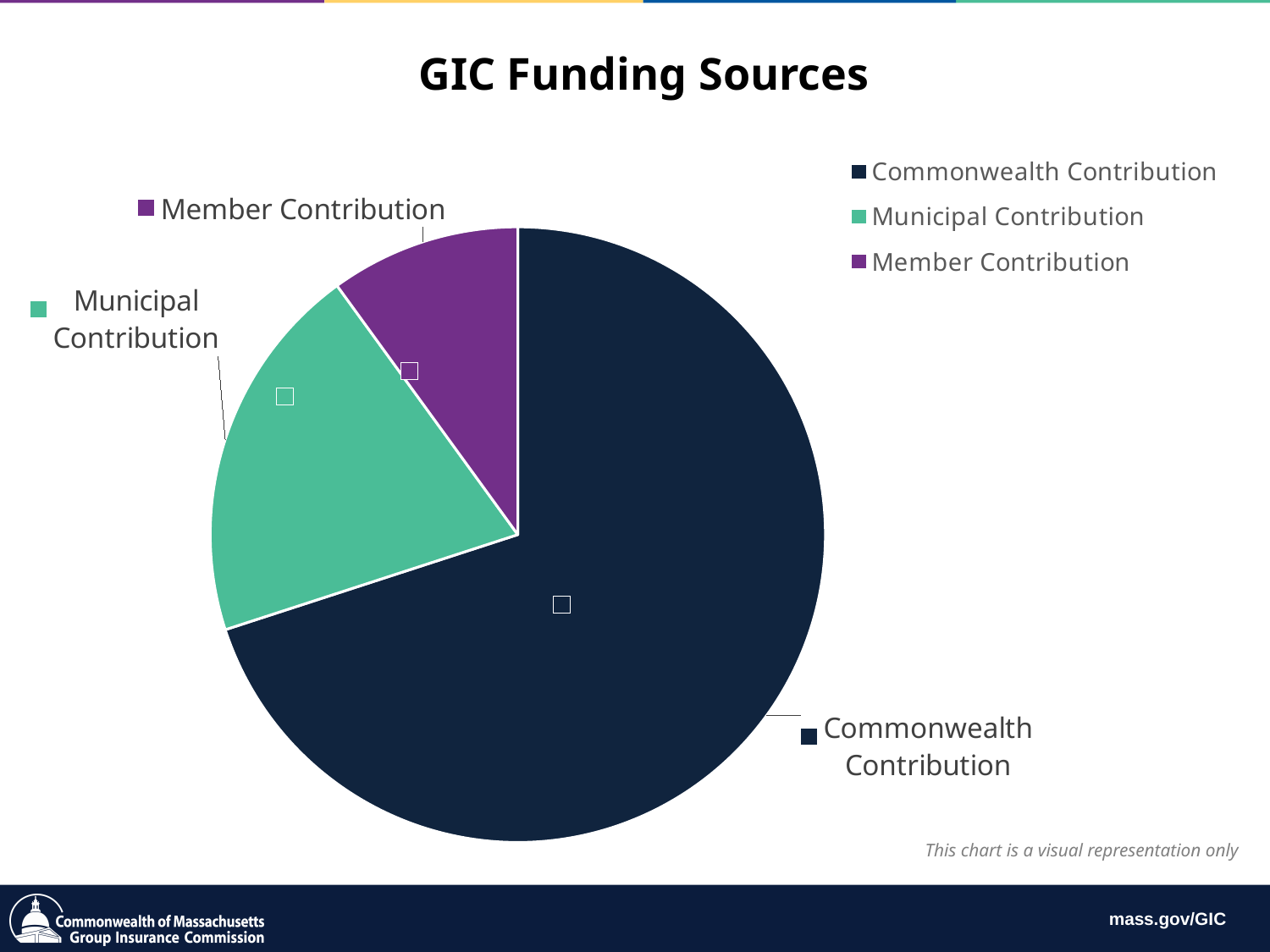
What is the title of the chart? GIC Funding Sources Which is larger, the Municipal Contribution slice or the Member Contribution slice? Municipal Contribution Which funding source has the smallest slice of the pie? Member Contribution What kind of chart is shown on the slide? pie chart How many slices does the pie chart have? 3 What colour is the Municipal Contribution slice? green How many entries does the legend list? 3 Which is larger, the Commonwealth Contribution slice or the Municipal Contribution slice? Commonwealth Contribution Which funding source has the largest slice of the pie? Commonwealth Contribution